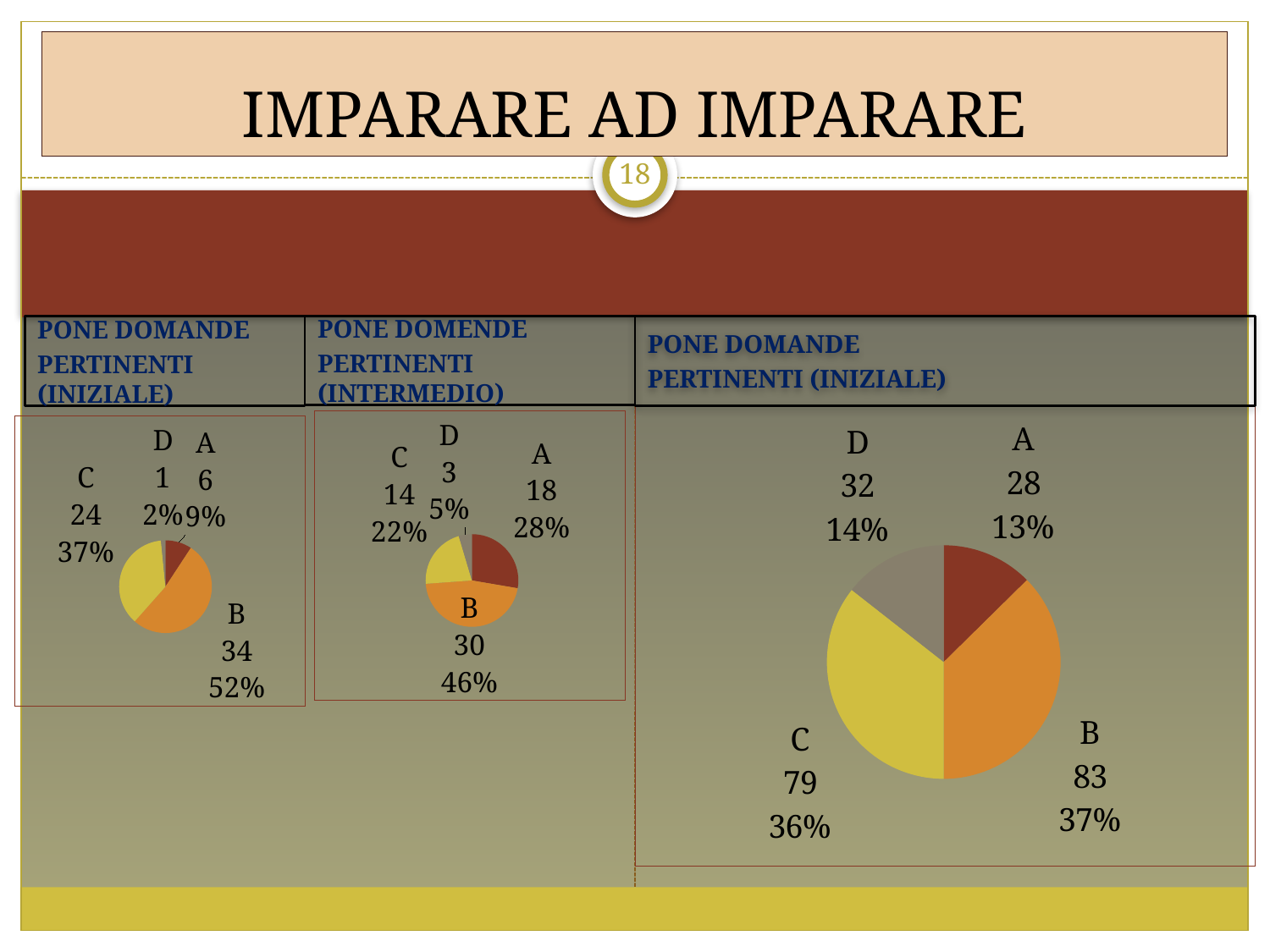
In the middle pie chart (PONE DOMENDE PERTINENTI (INTERMEDIO)), what is the value for A? 18 In the middle pie chart, what percentage share does D have? 5% In the left pie chart (PONE DOMANDE PERTINENTI (INIZIALE), small), what is the value for B? 34 What type of chart is used in the middle panel of the slide? Pie chart In the middle pie chart, which category has the largest value? B In the left pie chart, which category has the smallest value? D In the large pie chart on the right, what is the value for C? 79 In the left pie chart, what percentage share does C have? 37% In the middle pie chart, what is the difference between the values for B and C? 16 In the large pie chart on the right, what is the difference between the values for B and A? 55 In the large pie chart on the right, which is larger, the value for A or the value for D? D How many categories does the large pie chart on the right show? 4